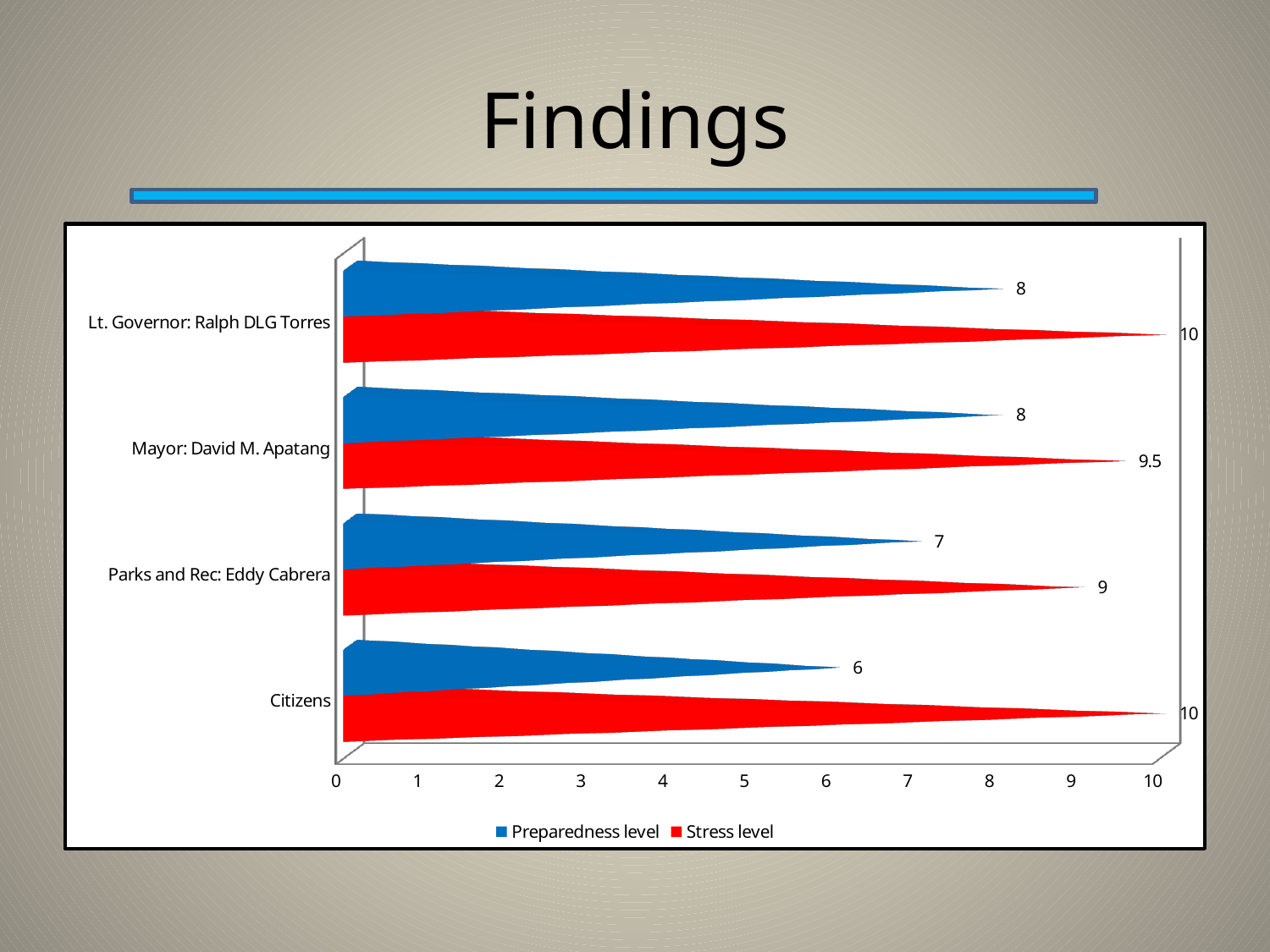
What is the Preparedness level for Parks and Rec: Eddy Cabrera? 7 What is the Preparedness level for Citizens? 6 Which is larger for Mayor: David M. Apatang, the Preparedness level or the Stress level? Stress level What is the Stress level for Lt. Governor: Ralph DLG Torres? 10 Which category has the lowest Preparedness level? Citizens Which category has the lowest Stress level? Parks and Rec: Eddy Cabrera How many series does the legend list? 2 What is the difference between the Stress level and the Preparedness level for Citizens? 4 How many categories are shown on the chart? 4 What is the Stress level for Mayor: David M. Apatang? 9.5 What kind of chart is shown on the slide? Bar chart What colour represents the Stress level series? Red